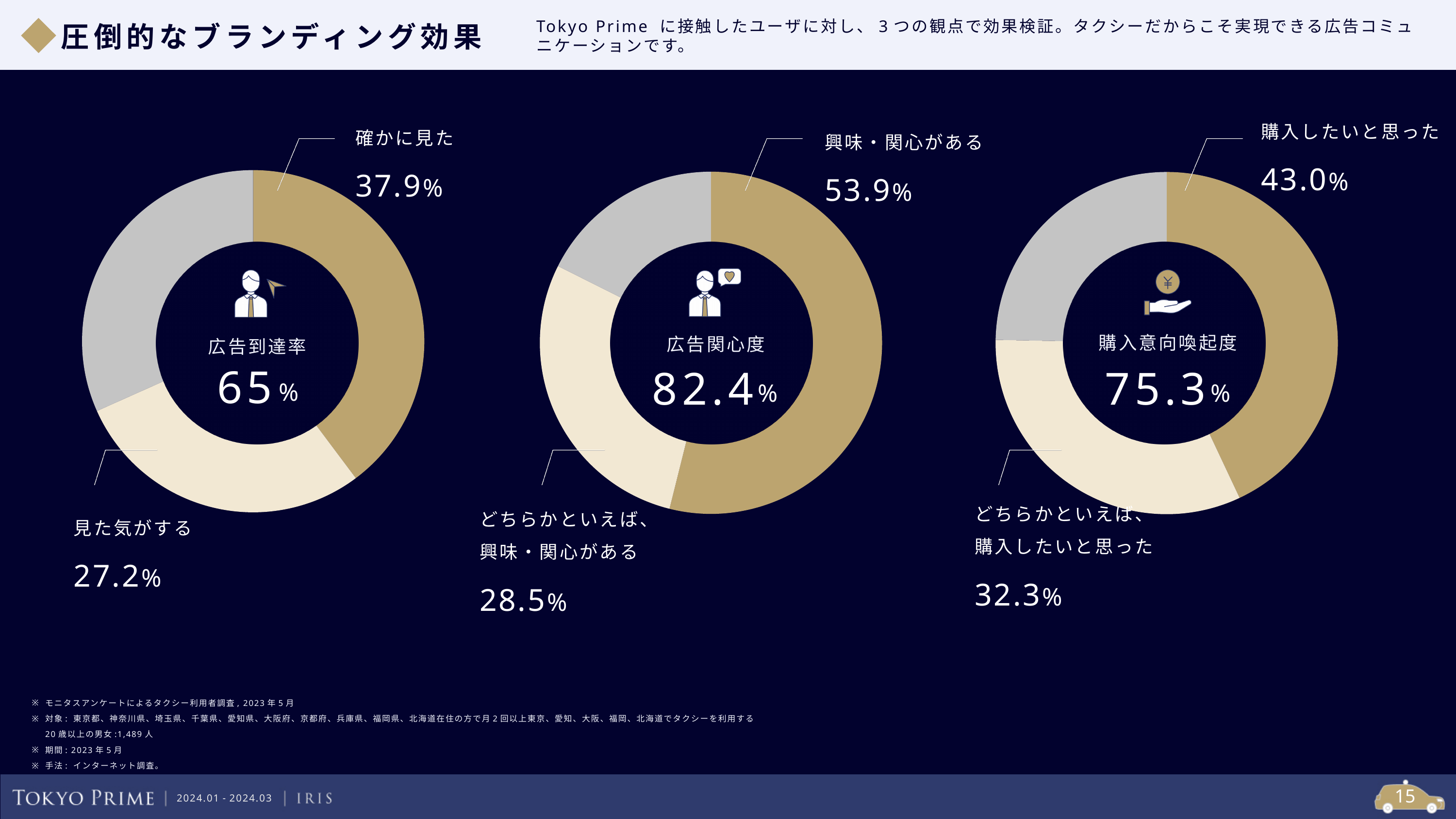
In the 広告関心度 chart in the middle, what percentage is shown for どちらかといえば、興味・関心がある? 28.5% In the 購入意向喚起度 chart on the right, which is larger: 購入したいと思った or どちらかといえば、購入したいと思った? 購入したいと思った In the 購入意向喚起度 chart on the right, what percentage is shown for 購入したいと思った? 43.0% What overall value is printed in the centre of the 広告関心度 chart in the middle? 82.4% In the 購入意向喚起度 chart on the right, what percentage is shown for どちらかといえば、購入したいと思った? 32.3% What kind of chart is used for the 広告到達率 chart on the left? Donut (pie) chart In the 広告到達率 chart on the left, what is the difference between 確かに見た and 見た気がする? 10.7% In the 広告関心度 chart in the middle, what percentage is shown for 興味・関心がある? 53.9% Which of the three charts has the highest overall value printed in its centre? 広告関心度 In the 広告到達率 chart on the left, what percentage is shown for 確かに見た? 37.9% In the 広告到達率 chart on the left, what percentage is shown for 見た気がする? 27.2% How many donut charts are shown on the slide? 3